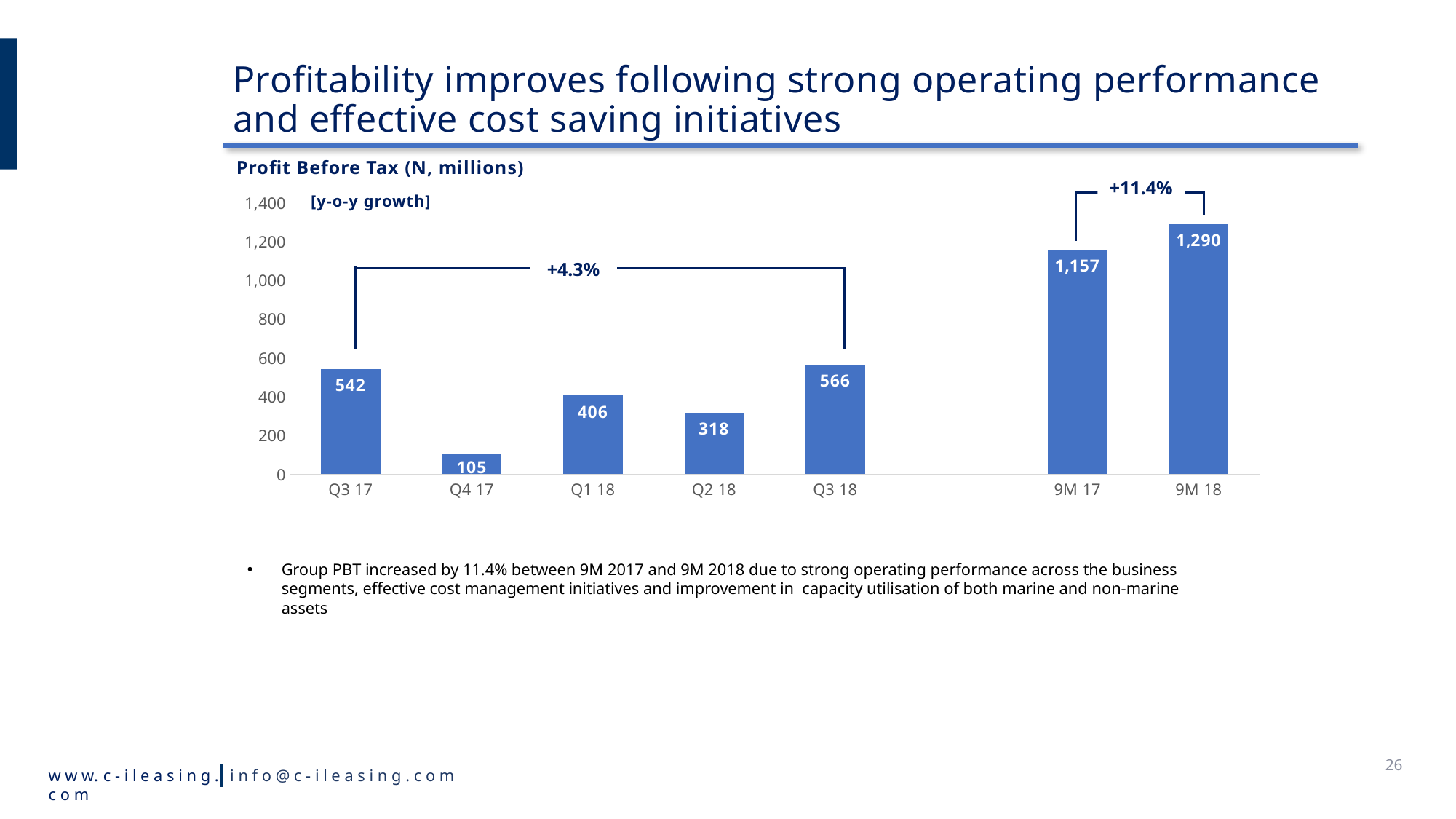
Which is larger, the Profit Before Tax for Q1 18 or Q2 18? Q1 18 What is the Profit Before Tax value for Q4 17? 105 Which category has the lowest Profit Before Tax? Q4 17 What kind of chart is shown on the slide? Bar chart What is the difference in Profit Before Tax between 9M 18 and 9M 17? 133 What is the difference in Profit Before Tax between Q3 18 and Q3 17? 24 What is the Profit Before Tax value for Q3 18? 566 How many categories are shown on the x axis? 7 What is the Profit Before Tax value for 9M 18? 1,290 Which category has the highest Profit Before Tax? 9M 18 What is the title of the chart? Profit Before Tax (N, millions) What y-o-y growth percentage is shown between 9M 17 and 9M 18? +11.4%